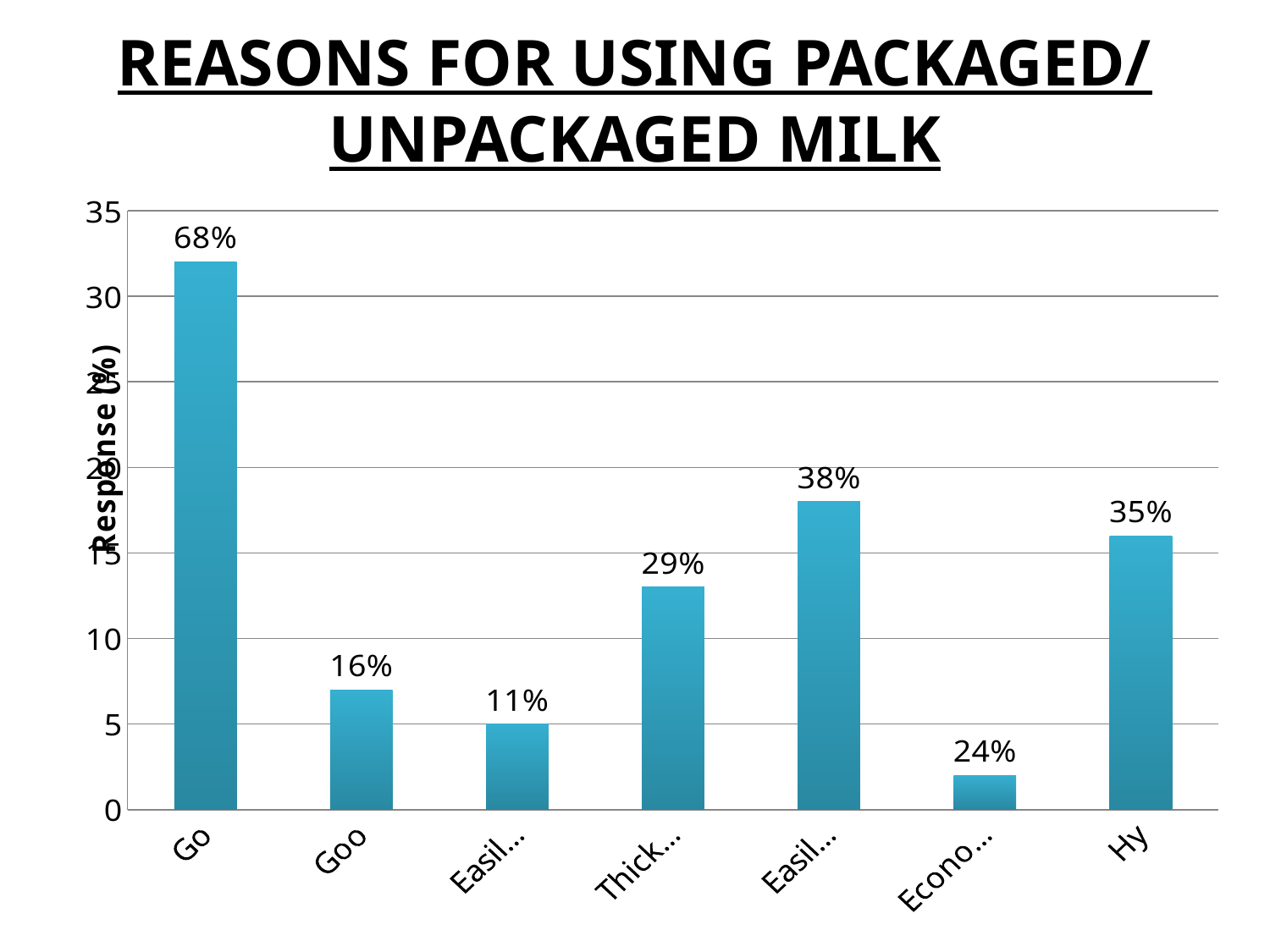
What value is printed above the fourth bar from the left? 29% What value is printed above the first (leftmost) bar? 68% What is the title of the chart on the slide? REASONS FOR USING PACKAGED/ UNPACKAGED MILK What kind of chart is shown on the slide? bar chart What value is printed above the second bar from the left? 16% What is the difference between the printed values of the first bar (68%) and the last bar (35%)? 33% Which bar has the highest value in the chart? the first (leftmost) bar, 68% What value is printed above the fifth bar from the left? 38% What is the label on the vertical axis of the chart? Response (%) What value is printed above the last (rightmost) bar, labelled 'Hy'? 35% Which is larger: the value of the fifth bar (38%) or the last bar (35%)? the fifth bar, 38% How many bars (categories) does the chart show? 7